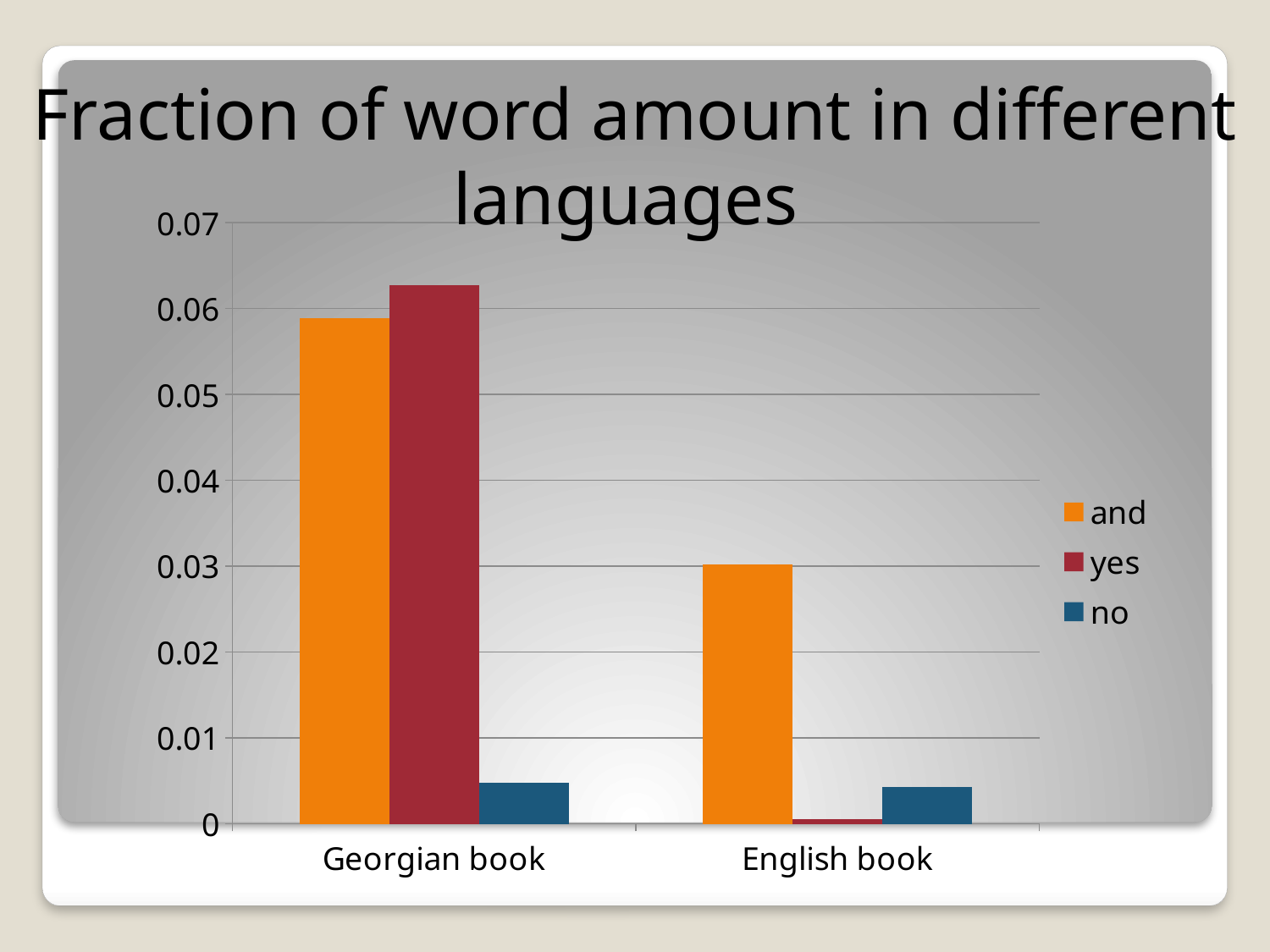
What kind of chart is shown on the slide? bar chart What is the title of the chart? Fraction of word amount in different languages How many series does the legend list? 3 How many categories are shown on the x axis? 2 Is the value for "and" in the Georgian book greater or less than 0.05? greater Which series has the shortest bar for the English book? yes Which series has the tallest bar for the Georgian book? yes Which colour represents the "no" series in the legend? blue Is the value for "no" in the Georgian book greater or less than 0.01? less Is the value for "and" in the English book greater or less than 0.04? less Which series has the tallest bar for the English book? and Which is larger: the value for "and" in the Georgian book or in the English book? Georgian book